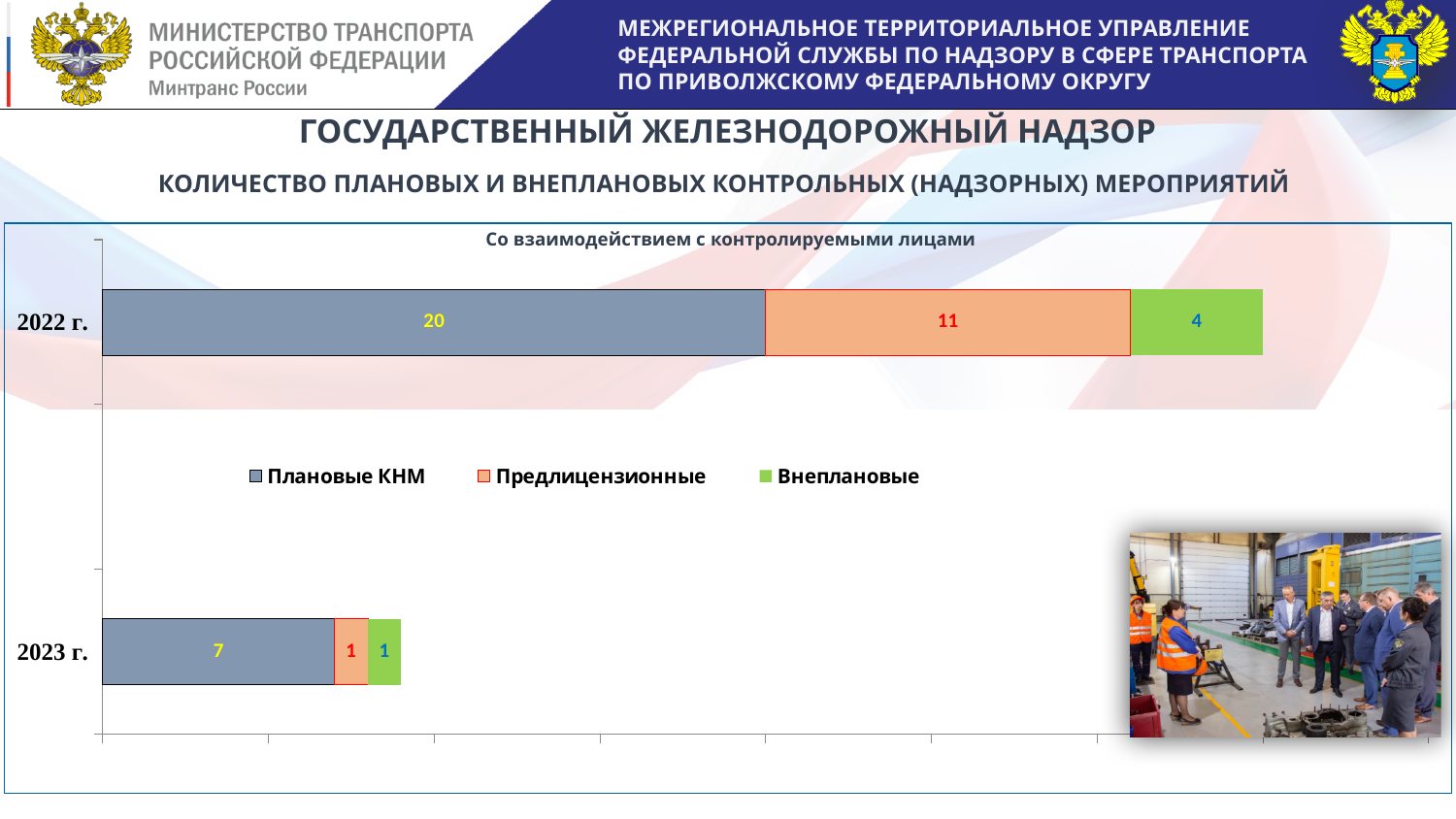
What is the total of the stacked bar for 2022 г.? 35 What is the value of Плановые КНМ for 2022 г.? 20 Which year has the higher value for Предлицензионные, 2022 г. or 2023 г.? 2022 г. How many categories (years) are shown on the chart? 2 What is the value of Плановые КНМ for 2023 г.? 7 What is the difference between Плановые КНМ in 2022 г. and 2023 г.? 13 What is the value of Предлицензионные for 2022 г.? 11 What kind of chart is shown on the slide? Stacked bar chart Which series has the highest value in 2022 г.? Плановые КНМ How many series does the legend list? 3 What is the total of the stacked bar for 2023 г.? 9 What is the value of Внеплановые for 2023 г.? 1